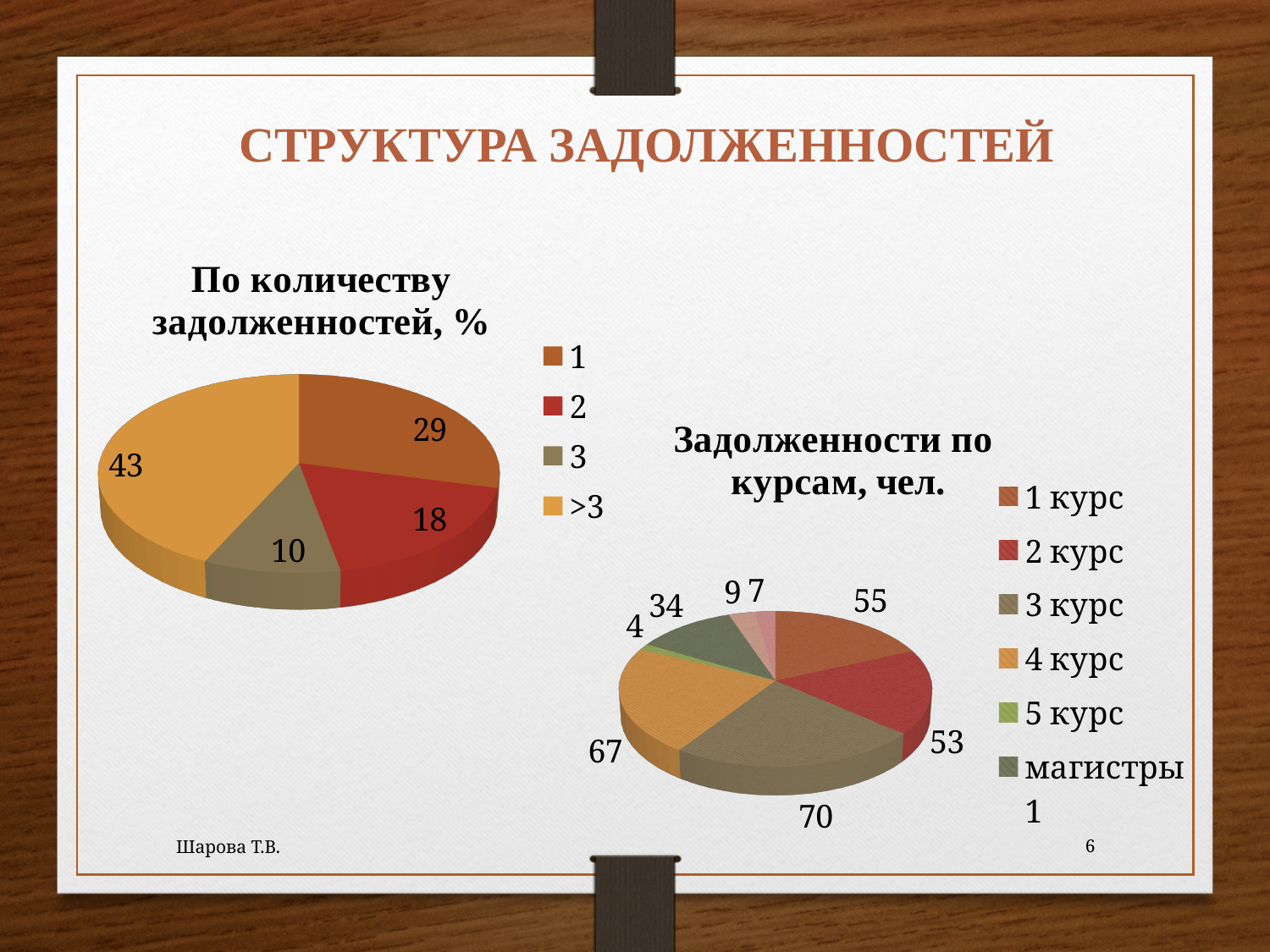
What kind of chart is 'Задолженности по курсам, чел.'? pie chart In the chart 'По количеству задолженностей, %', how many categories does the legend list? 4 In the chart 'Задолженности по курсам, чел.', what is the value for '5 курс'? 4 In the chart 'По количеству задолженностей, %', what is the value for the category '>3'? 43 In the chart 'По количеству задолженностей, %', which category has the smallest slice? 3 In the chart 'Задолженности по курсам, чел.', what is the value for '3 курс'? 70 What is the title of the slide? СТРУКТУРА ЗАДОЛЖЕННОСТЕЙ In the chart 'По количеству задолженностей, %', what is the value for the category '2'? 18 In the chart 'По количеству задолженностей, %', what is the difference between the values for '1' and '2'? 11 In the chart 'Задолженности по курсам, чел.', which is larger: the value for '1 курс' or the value for '4 курс'? 4 курс In the chart 'По количеству задолженностей, %', which category has the largest slice? >3 In the chart 'Задолженности по курсам, чел.', what is the difference between the values for '3 курс' and '4 курс'? 3